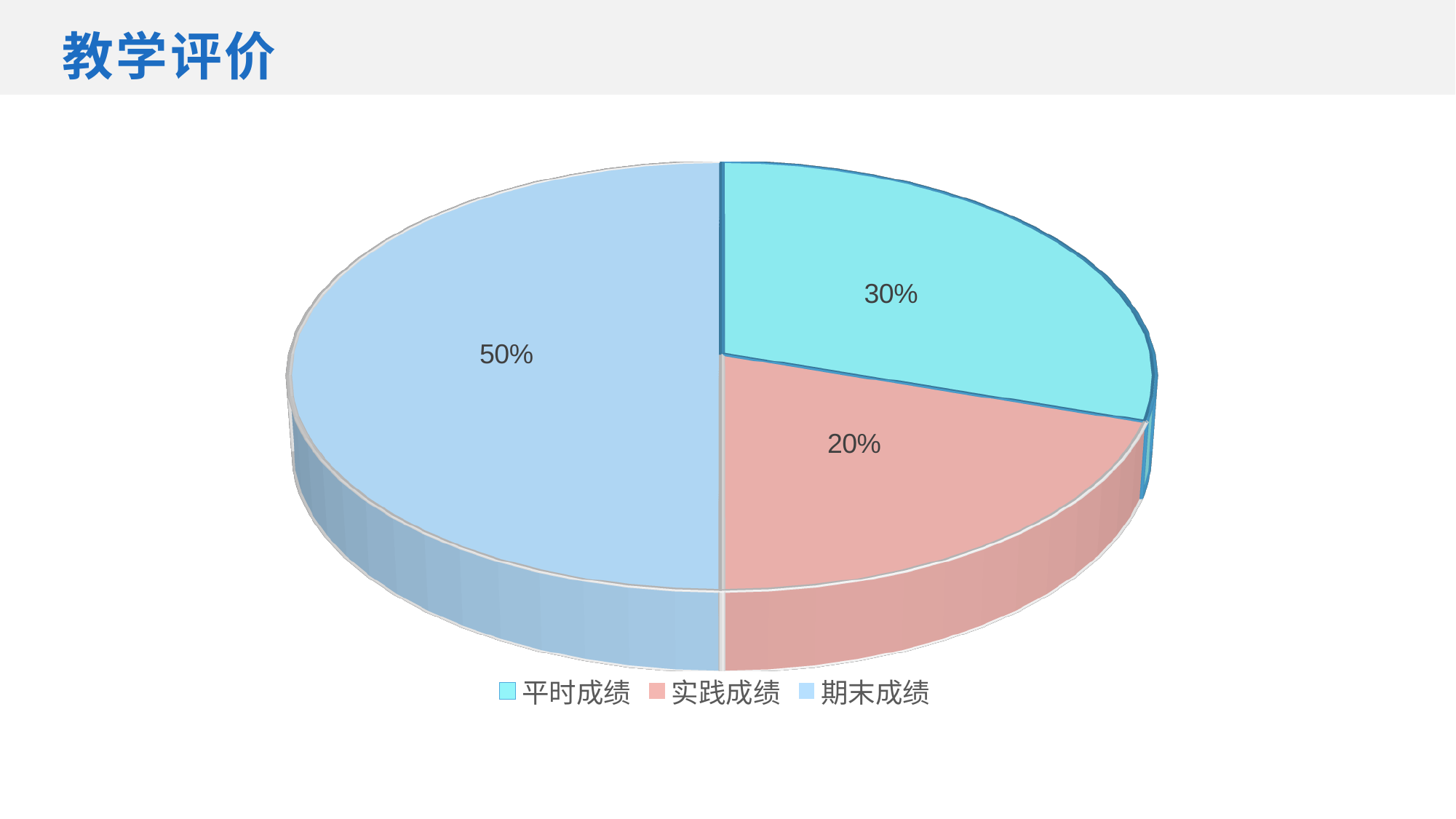
Which is larger, the slice for 平时成绩 or the slice for 实践成绩? 平时成绩 What share of the pie does 平时成绩 represent? 30% What is the difference in percentage points between 期末成绩 and 平时成绩? 20% What share of the pie does 实践成绩 represent? 20% What is the title of the slide containing the chart? 教学评价 Which category has the largest slice of the pie? 期末成绩 What is the difference in percentage points between 平时成绩 and 实践成绩? 10% What colour is the slice for 实践成绩? Pink What share of the pie does 期末成绩 represent? 50% How many slices does the pie chart have? 3 What kind of chart is shown on the slide? Pie chart Which category has the smallest slice of the pie? 实践成绩